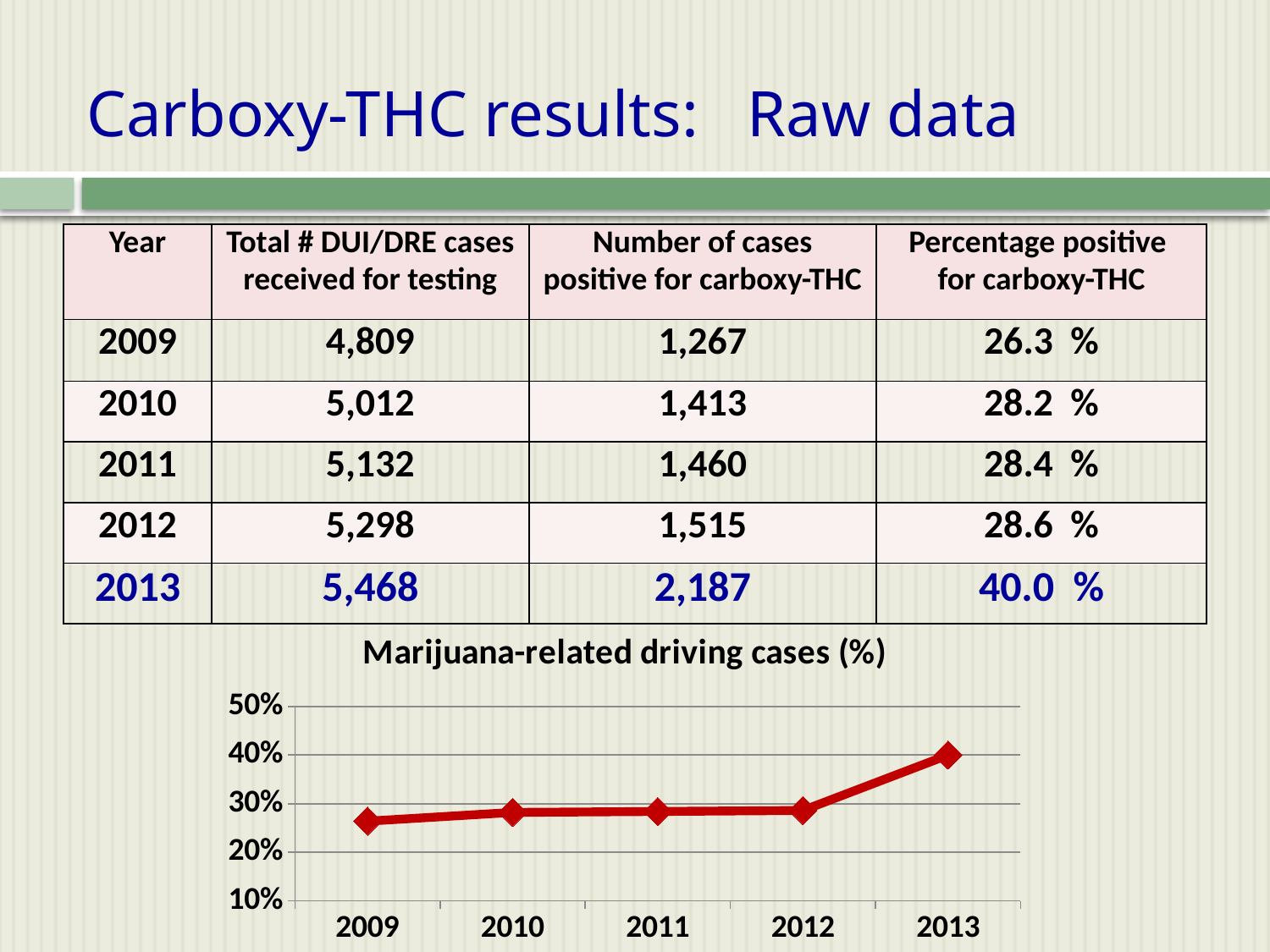
What kind of chart is shown below the table? line chart Is the value for 2009 on the chart greater or less than 30%? less What is the title of the chart? Marijuana-related driving cases (%) Which is larger on the chart, the value for 2012 or the value for 2013? 2013 Which year has the lowest value on the chart? 2009 Is the value for 2013 on the chart greater or less than 30%? greater Which year has the highest value on the chart? 2013 How many data points are plotted on the chart? 5 What colour is the line on the chart? red What value does the 2013 point on the chart reach on the vertical axis? 40% Do the values on the chart rise or fall from 2009 to 2013? rise Is the value for 2011 on the chart greater or less than 20%? greater